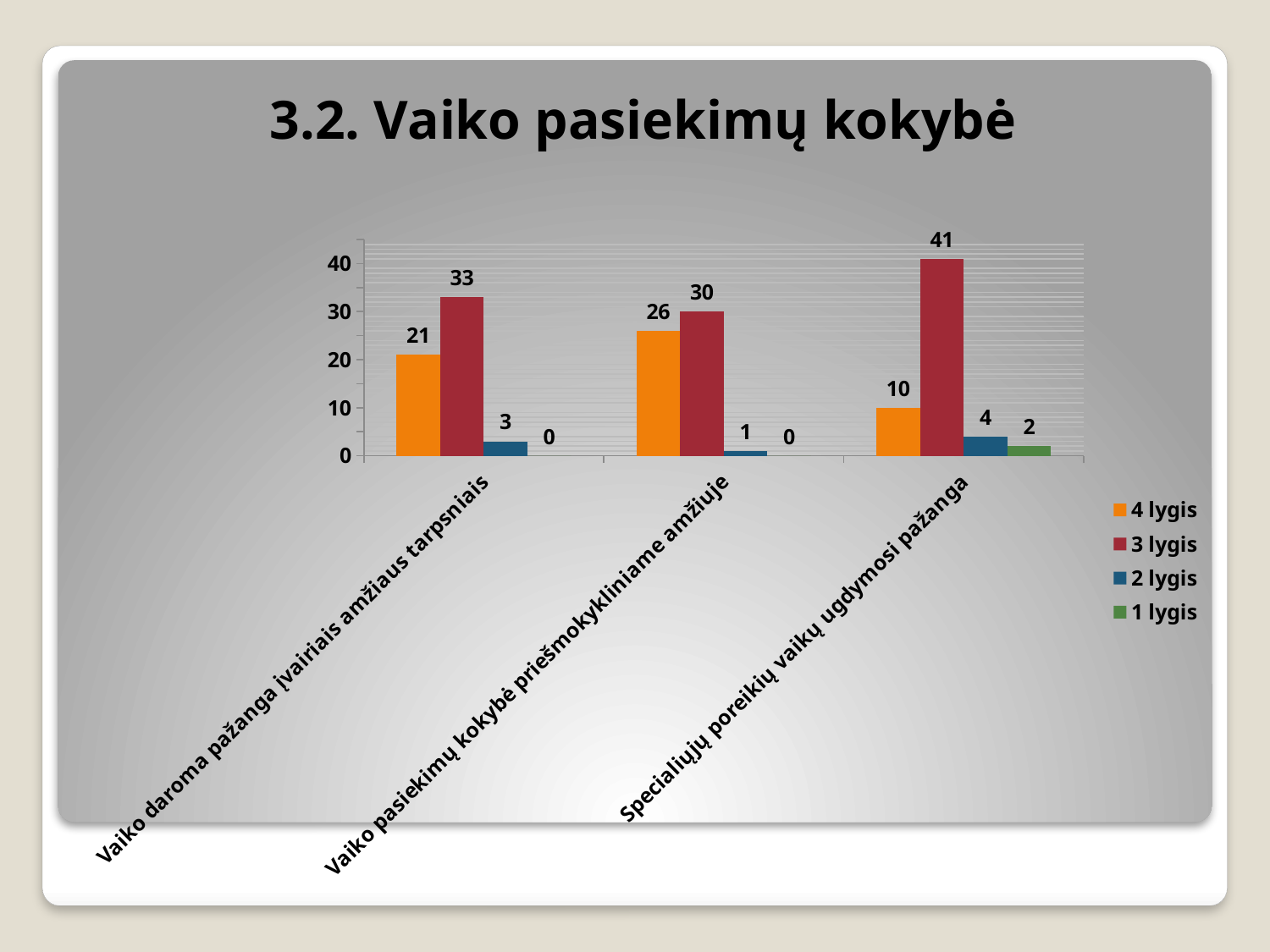
How many series does the legend list? 4 Which is larger for 'Vaiko pasiekimų kokybė priešmokykliniame amžiuje': the 4 lygis value or the 3 lygis value? 3 lygis Which category has the lowest value for the 4 lygis series? Specialiųjų poreikių vaikų ugdymosi pažanga What is the title of the slide? 3.2. Vaiko pasiekimų kokybė What is the value of the 2 lygis series for 'Vaiko daroma pažanga įvairiais amžiaus tarpsniais'? 3 Which category has the highest value for the 3 lygis series? Specialiųjų poreikių vaikų ugdymosi pažanga What is the difference between the 3 lygis and 4 lygis values for 'Vaiko daroma pažanga įvairiais amžiaus tarpsniais'? 12 Is the 3 lygis value for 'Specialiųjų poreikių vaikų ugdymosi pažanga' greater or less than 40? greater What is the value of the 3 lygis series for 'Specialiųjų poreikių vaikų ugdymosi pažanga'? 41 What is the value of the 4 lygis series for 'Vaiko pasiekimų kokybė priešmokykliniame amžiuje'? 26 How many categories are shown on the x axis? 3 What kind of chart is shown on the slide? bar chart